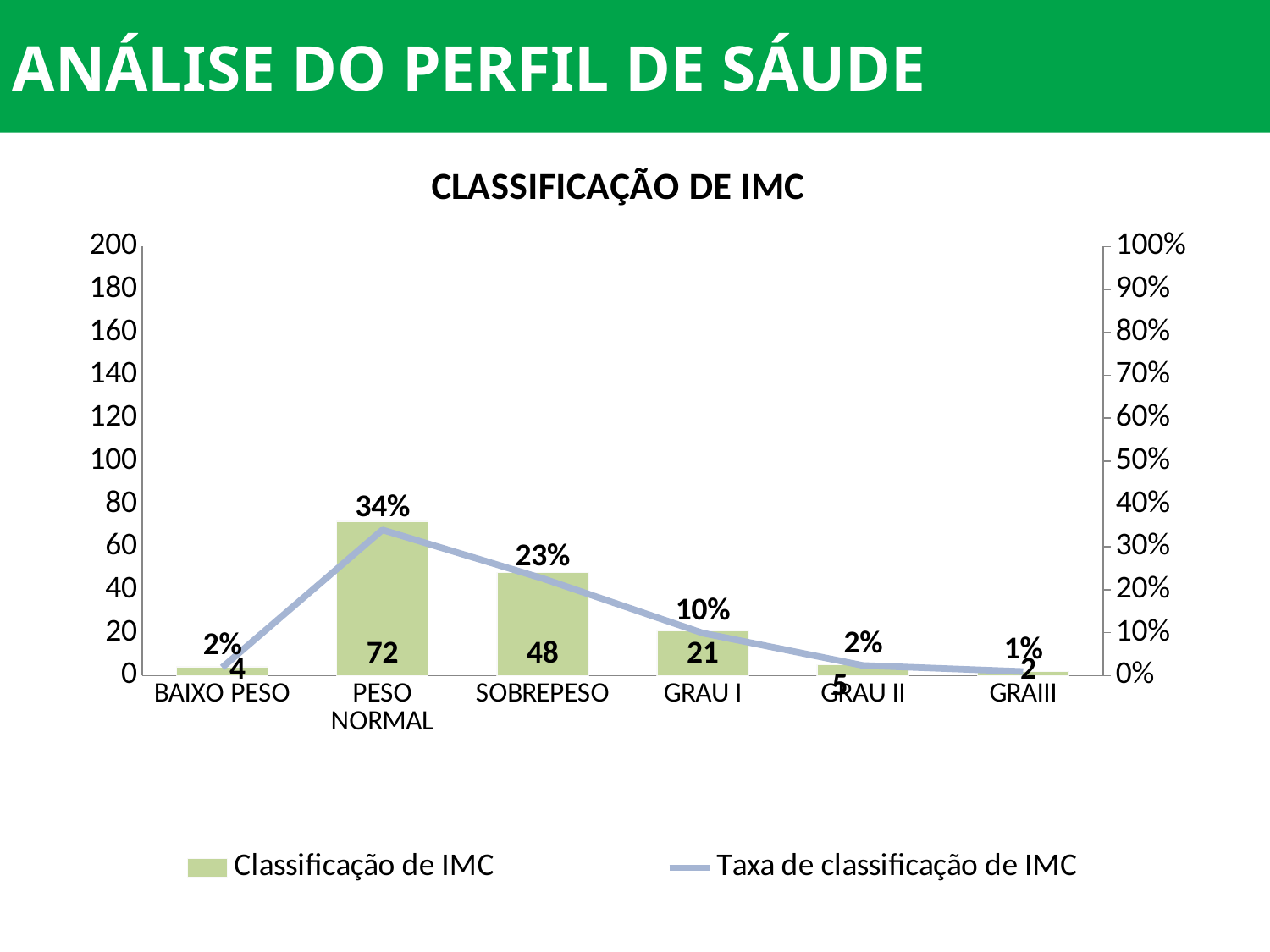
How many series does the legend list? 2 Which category has the lowest Classificação de IMC value? GRAIII What is the Taxa de classificação de IMC for GRAU I? 10% Does the Taxa de classificação de IMC line rise or fall from PESO NORMAL to GRAIII? fall How many categories are shown on the x axis? 6 What is the Classificação de IMC value for SOBREPESO? 48 What is the Taxa de classificação de IMC for PESO NORMAL? 34% What is the Classificação de IMC value for PESO NORMAL? 72 Which is larger, the Classificação de IMC value for GRAU I or for GRAU II? GRAU I What is the difference between the Classificação de IMC values for PESO NORMAL and SOBREPESO? 24 What is the title of the chart? CLASSIFICAÇÃO DE IMC Which category has the highest Classificação de IMC value? PESO NORMAL